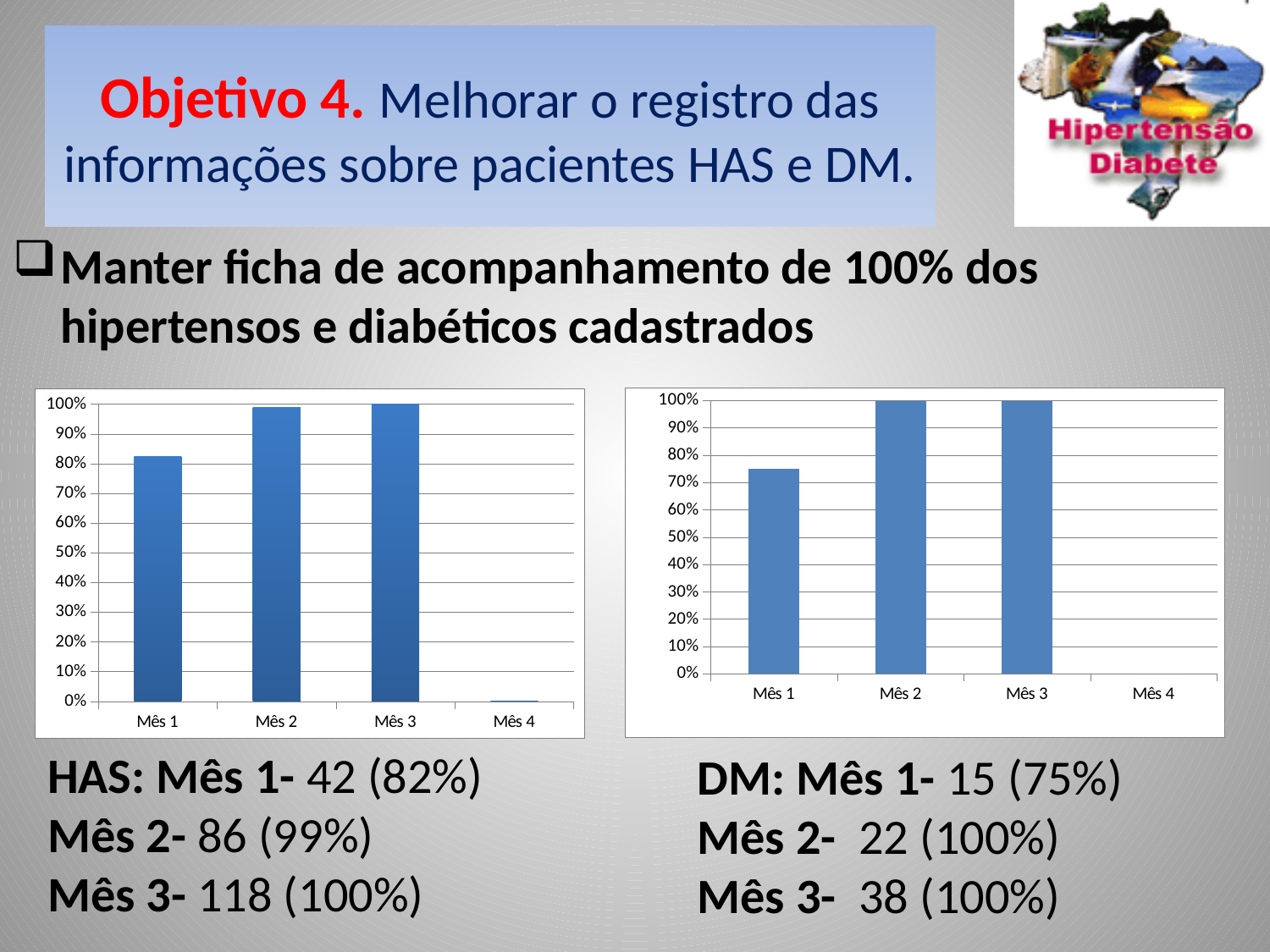
In the left chart, is the value for Mês 1 greater or less than 80%? greater Do the bars in the right chart rise or fall from Mês 1 to Mês 3? rise In the right chart, which month has the lowest bar among Mês 1, Mês 2 and Mês 3? Mês 1 What kind of chart is the left chart on the slide? bar chart How many categories are shown on the x axis of the right chart? 4 According to the text below the left chart, what percentage is shown for HAS in Mês 1? 82% In the left chart, what value does the bar for Mês 3 reach? 100% In the left chart, is the bar for Mês 1 larger or smaller than the bar for Mês 2? smaller In the right chart, is the value for Mês 1 greater or less than 80%? less In the right chart, what value does the bar for Mês 2 reach? 100% In the left chart, which month has the lowest bar among Mês 1, Mês 2 and Mês 3? Mês 1 According to the text below the right chart, what percentage is shown for DM in Mês 1? 75%